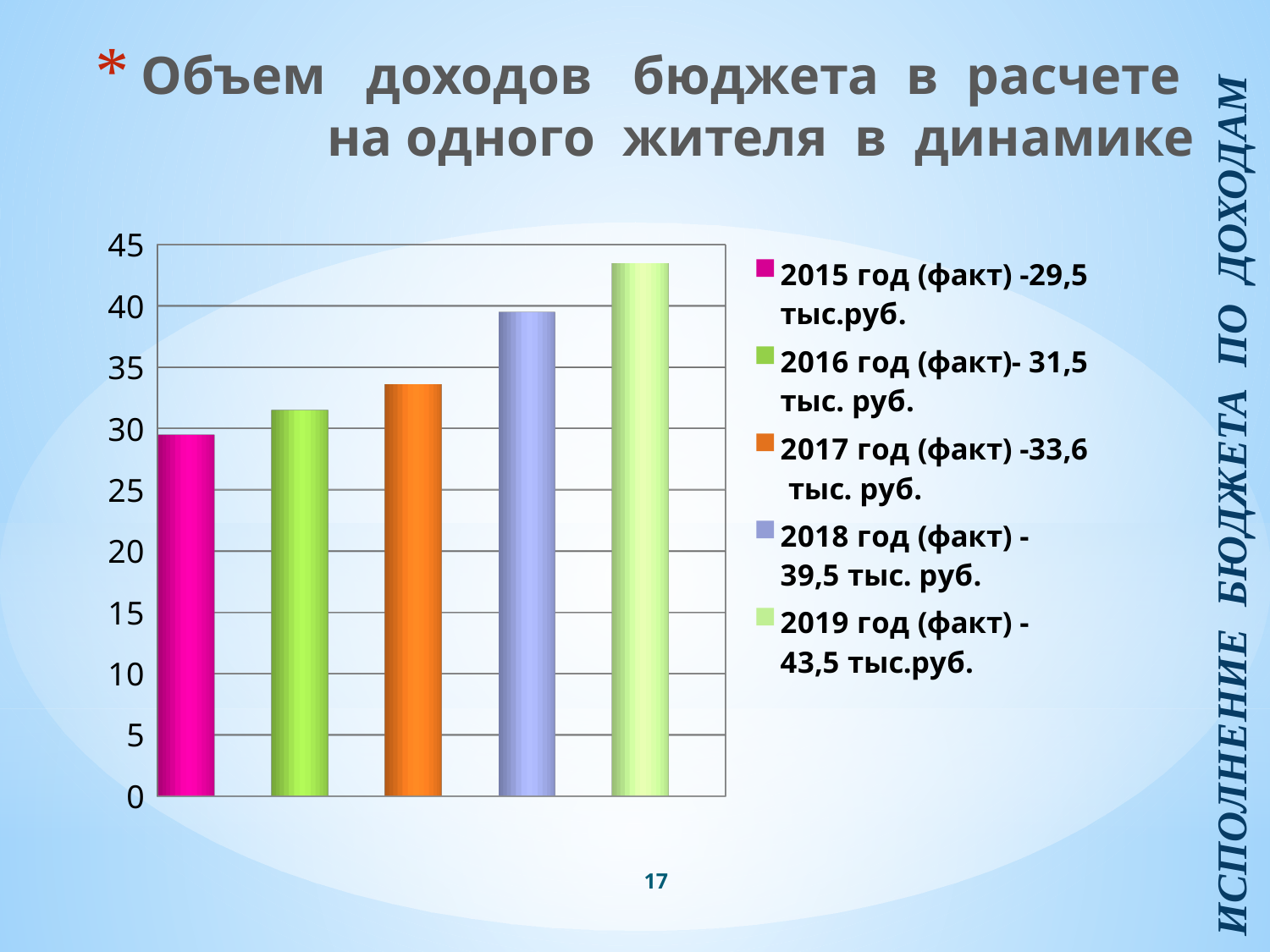
What kind of chart is shown on the slide? bar chart What is the value for 2019 год (факт) according to the legend? 43,5 тыс.руб. Is the value for 2018 greater or less than 35? greater How many bars does the chart have? 5 Which year has the highest value? 2019 год (факт) What is the value for 2015 год (факт) according to the legend? 29,5 тыс.руб. What is the value for 2017 год (факт) according to the legend? 33,6 тыс. руб. What is the difference between the values for 2019 and 2015? 14 тыс. руб. Which year has the lowest value? 2015 год (факт) How many entries does the legend list? 5 Do the values rise or fall from 2015 to 2019? rise Which is larger, the value for 2018 or the value for 2016? 2018